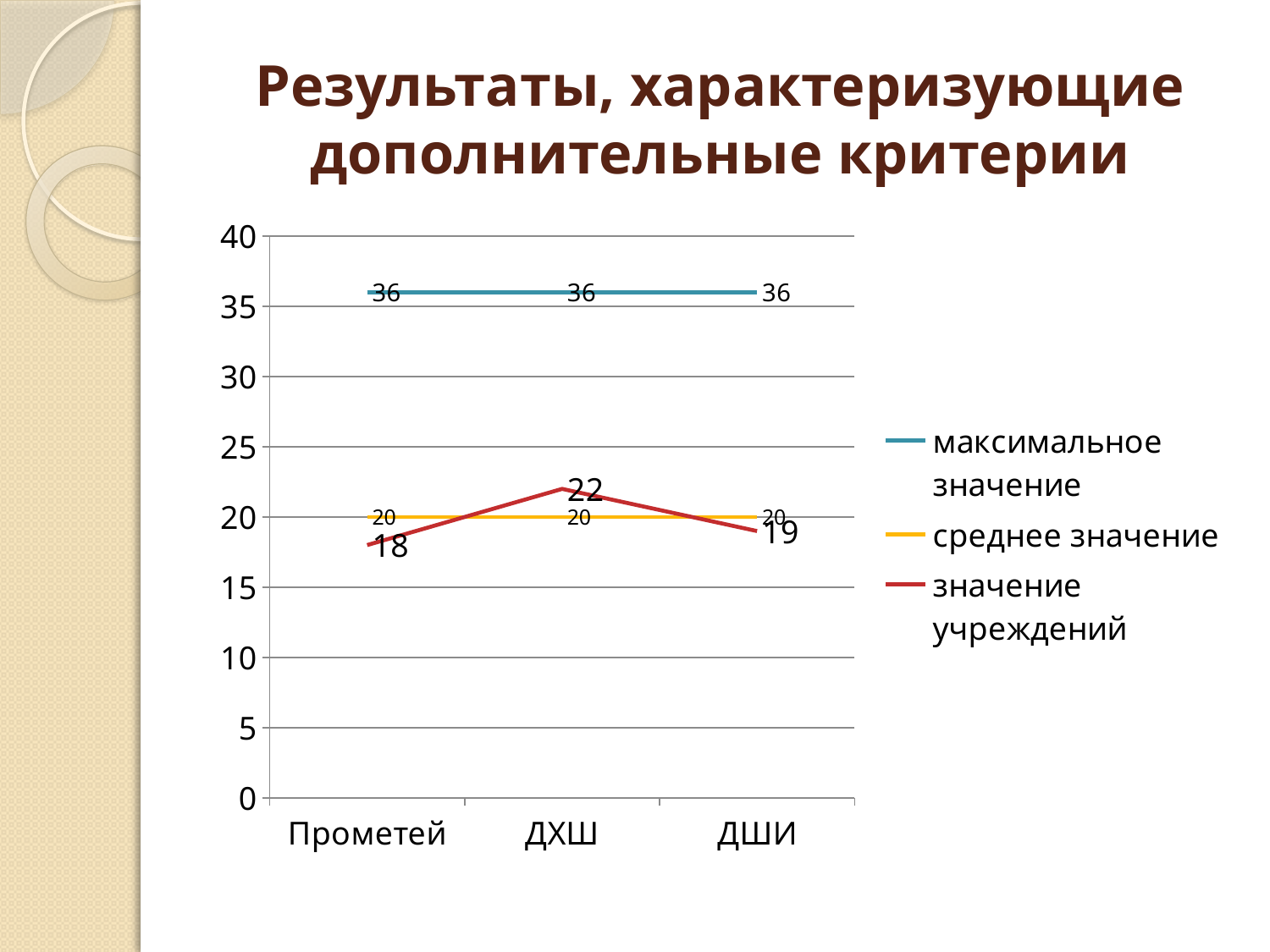
Which category has the lowest value for 'значение учреждений'? Прометей What is the difference between 'максимальное значение' and 'значение учреждений' for ДШИ? 17 What is the value of 'значение учреждений' for Прометей? 18 What is the title of the slide? Результаты, характеризующие дополнительные критерии What kind of chart is shown on the slide? line chart How many categories are shown on the x axis? 3 Which category has the highest value for 'значение учреждений'? ДХШ What is the value of 'максимальное значение' for ДШИ? 36 What is the value of 'значение учреждений' for ДХШ? 22 How many series does the legend list? 3 Which is larger for Прометей: 'среднее значение' or 'значение учреждений'? среднее значение What is the value of 'среднее значение' for ДХШ? 20